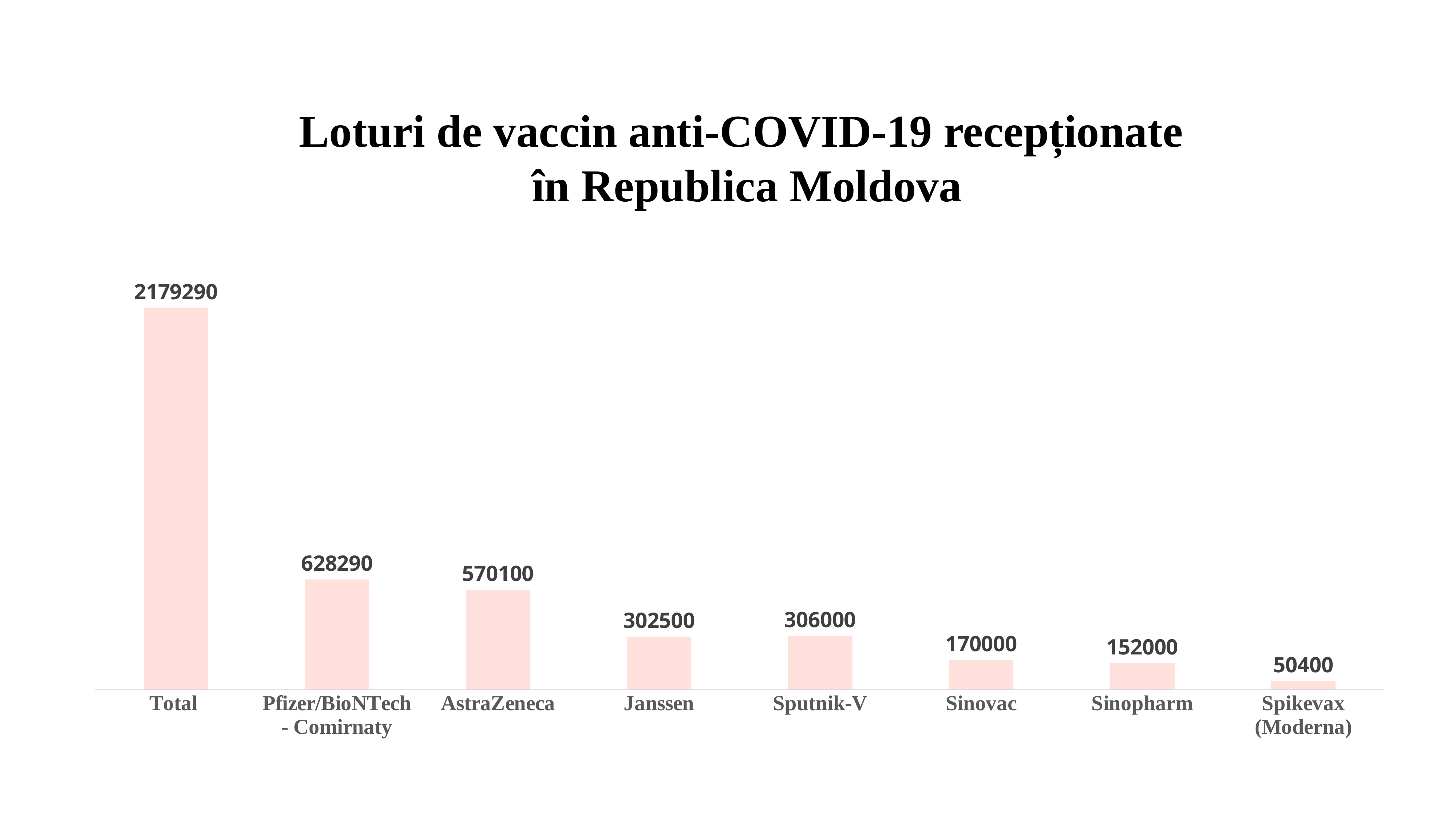
What is the title of the chart? Loturi de vaccin anti-COVID-19 recepționate în Republica Moldova Excluding the Total bar, which vaccine has the highest value? Pfizer/BioNTech - Comirnaty What is the value for AstraZeneca? 570100 Which category has the lowest value? Spikevax (Moderna) What kind of chart is shown on the slide? Bar chart What is the difference between the values for Sinovac and Sinopharm? 18000 What is the difference between the values for Pfizer/BioNTech - Comirnaty and AstraZeneca? 58190 What is the value for Spikevax (Moderna)? 50400 What is the value shown for the Total bar? 2179290 How many categories are shown on the x axis? 8 What is the value for Sinopharm? 152000 Which is larger, the value for Janssen or the value for Sputnik-V? Sputnik-V